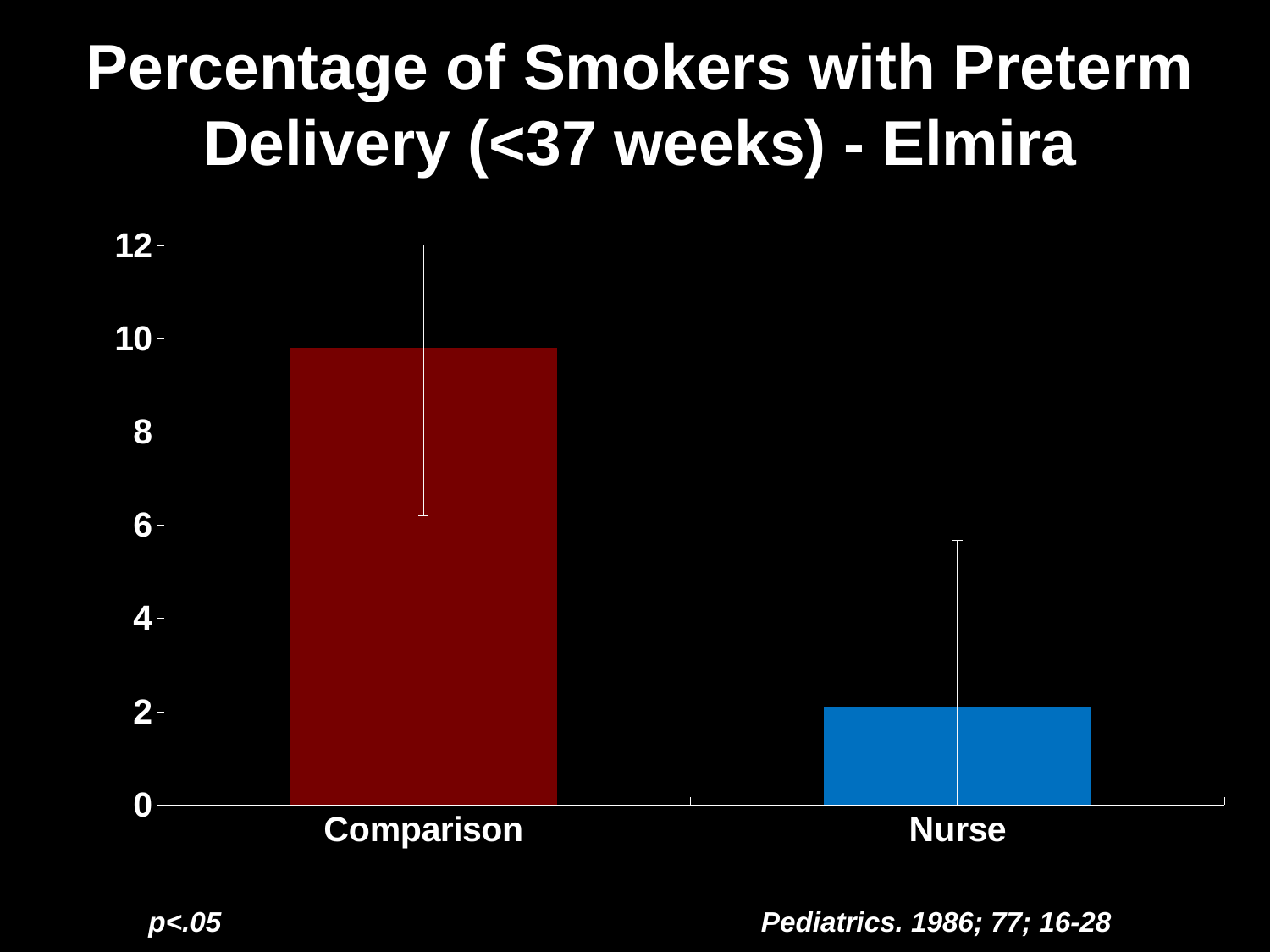
What kind of chart is shown on the slide? bar chart Is the value for Nurse greater or less than 4? less How many categories are plotted on the chart? 2 Which category has the lowest value? Nurse What colour is the bar for Nurse? blue Is the value for Comparison greater or less than 8? greater Is the value for Nurse greater or less than 6? less What is the title of the chart? Percentage of Smokers with Preterm Delivery (<37 weeks) - Elmira Which is larger, the value for Comparison or the value for Nurse? Comparison Which category has the highest value? Comparison